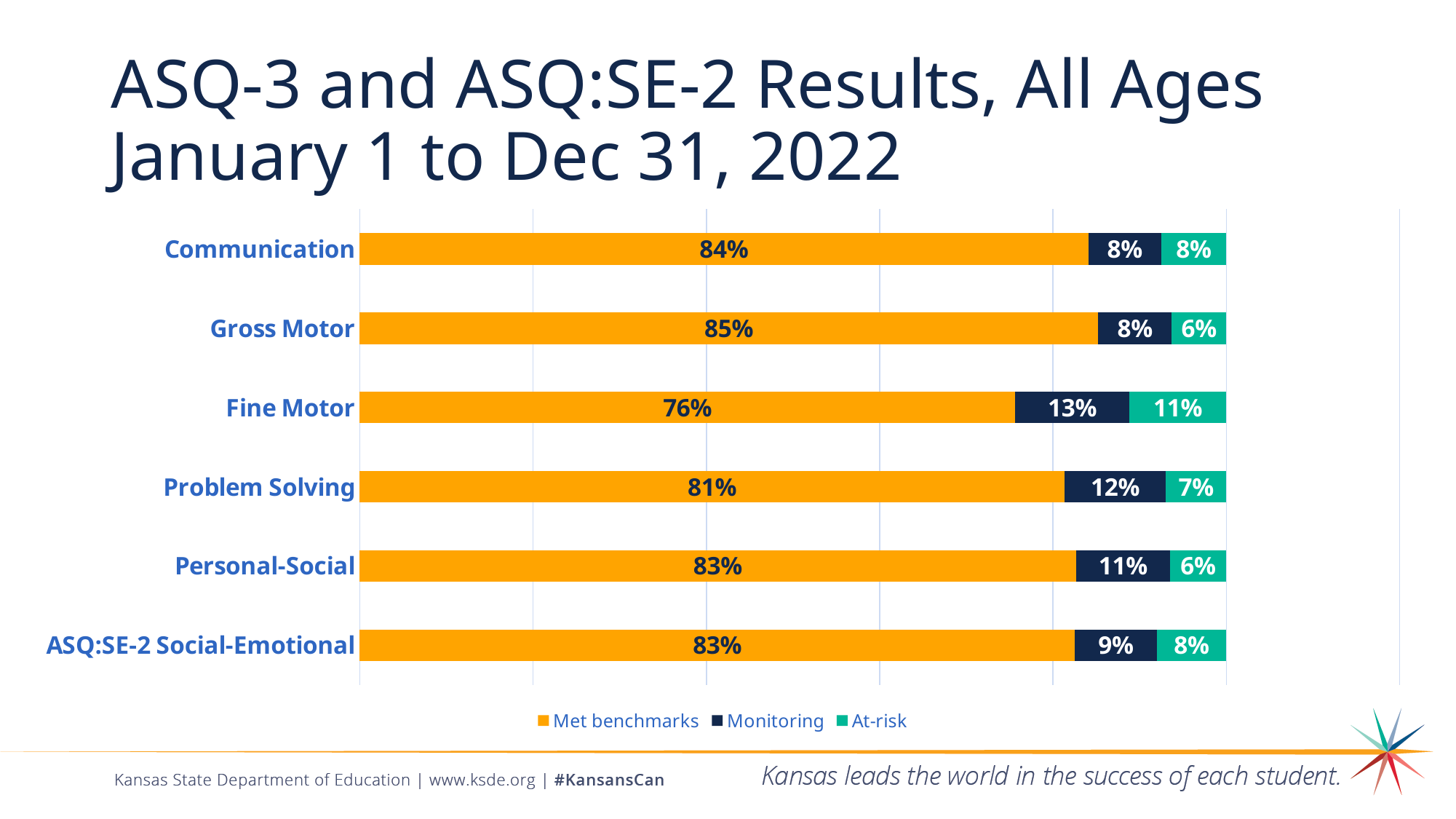
How many categories are shown in the chart? 6 Which is larger, the Monitoring percentage for Problem Solving or for Personal-Social? Problem Solving Which category has the highest Met benchmarks percentage? Gross Motor What is the At-risk percentage for Problem Solving? 7% What is the difference between the Met benchmarks percentages for Gross Motor and Fine Motor? 9% What is the Monitoring percentage for Fine Motor? 13% What kind of chart is shown on the slide? Stacked bar chart What percentage of Communication results met benchmarks? 84% How many series does the legend list? 3 Which category has the lowest Met benchmarks percentage? Fine Motor What is the Met benchmarks percentage for ASQ:SE-2 Social-Emotional? 83% Which category has the highest At-risk percentage? Fine Motor